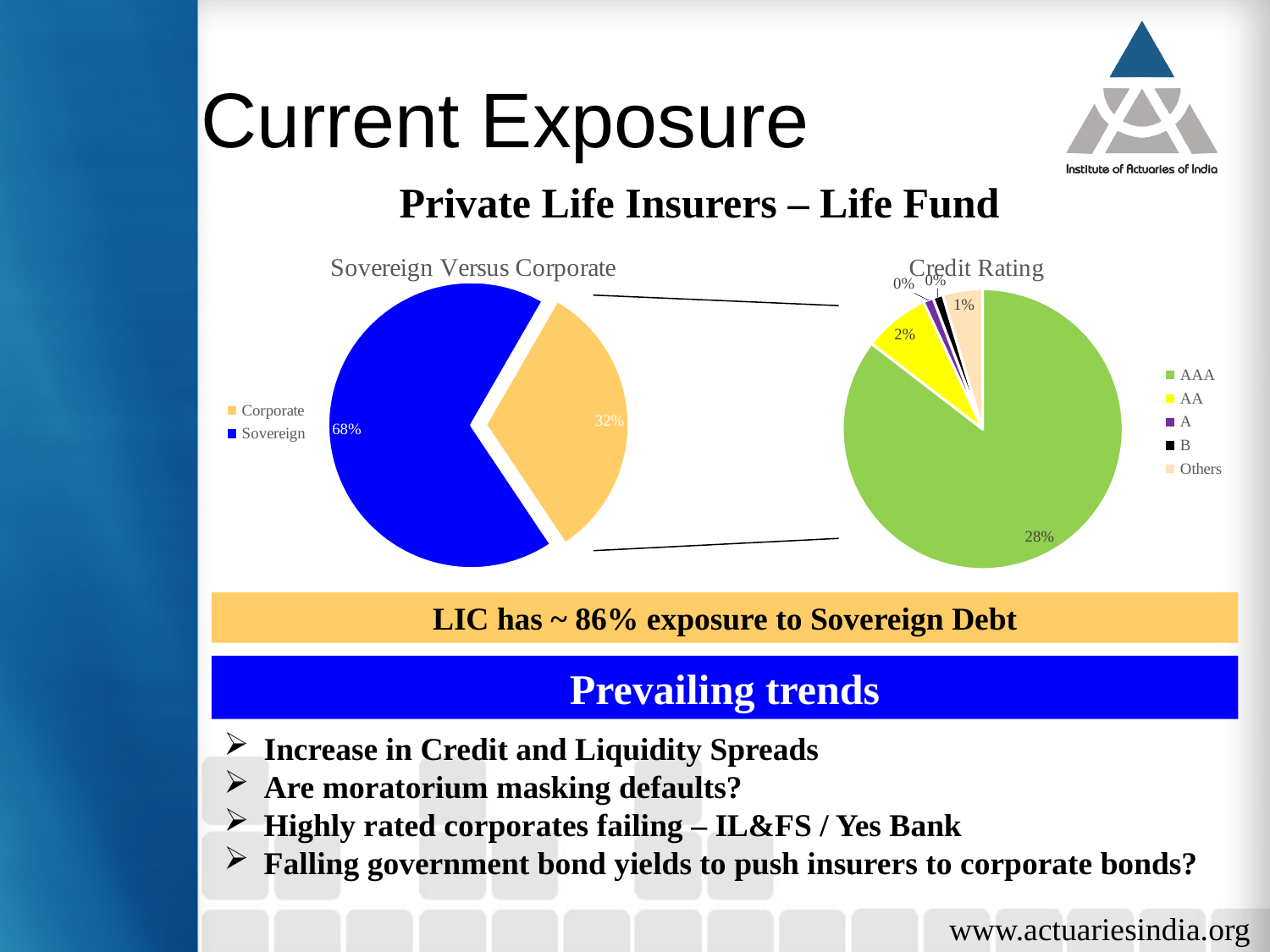
In the Credit Rating chart, which rating category has the largest slice? AAA In the Sovereign Versus Corporate chart, what percentage is labelled for Corporate? 32% What kind of chart is the Sovereign Versus Corporate chart? Pie chart In the Credit Rating chart, what percentage is labelled for AAA? 28% In the Sovereign Versus Corporate chart, what is the difference between the Sovereign and Corporate percentages? 36% In the Credit Rating chart, what percentage is labelled for Others? 1% How many categories does the legend of the Credit Rating chart list? 5 In the Sovereign Versus Corporate chart, which category has the larger share? Sovereign What colour is the Sovereign slice in the Sovereign Versus Corporate chart? Blue In the Credit Rating chart, what percentage is labelled for AA? 2% In the Sovereign Versus Corporate chart, what percentage is labelled for Sovereign? 68% In the Credit Rating chart, which is larger, the AA slice or the Others slice? AA